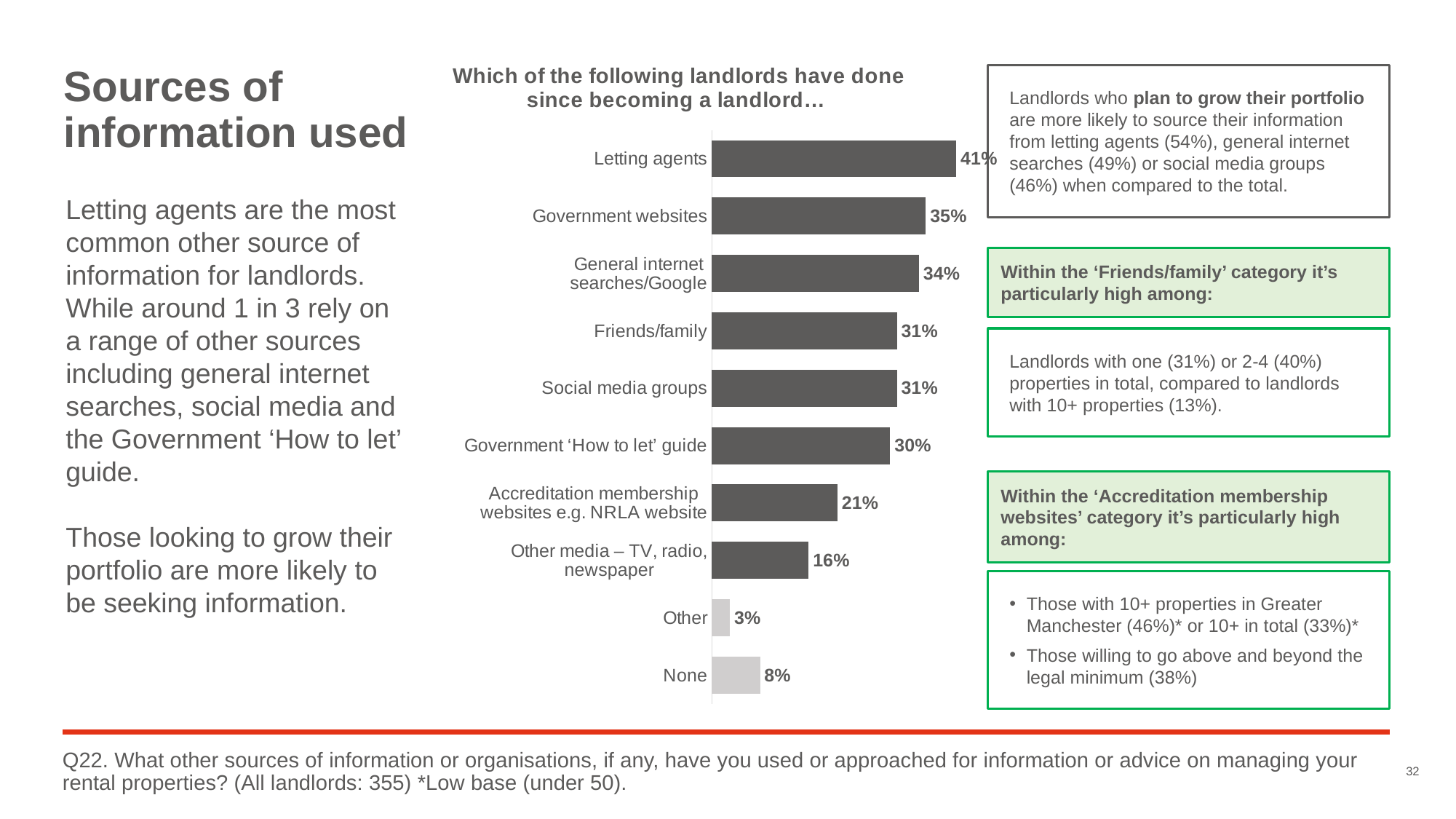
What is the difference in percentage points between Government 'How to let' guide and Other media – TV, radio, newspaper? 14 What type of chart is shown on the slide? Bar chart What percentage of landlords have used letting agents as a source of information? 41% Which is larger, the value for General internet searches/Google or the value for Friends/family? General internet searches/Google Which source of information has the highest percentage? Letting agents Which category has the lowest percentage? Other What is the value for None? 8% What percentage is shown for Accreditation membership websites e.g. NRLA website? 21% What is the title of the chart? Which of the following landlords have done since becoming a landlord… How many categories are shown in the chart? 10 What is the difference in percentage points between Letting agents and Government websites? 6 What is the value shown for Government websites? 35%